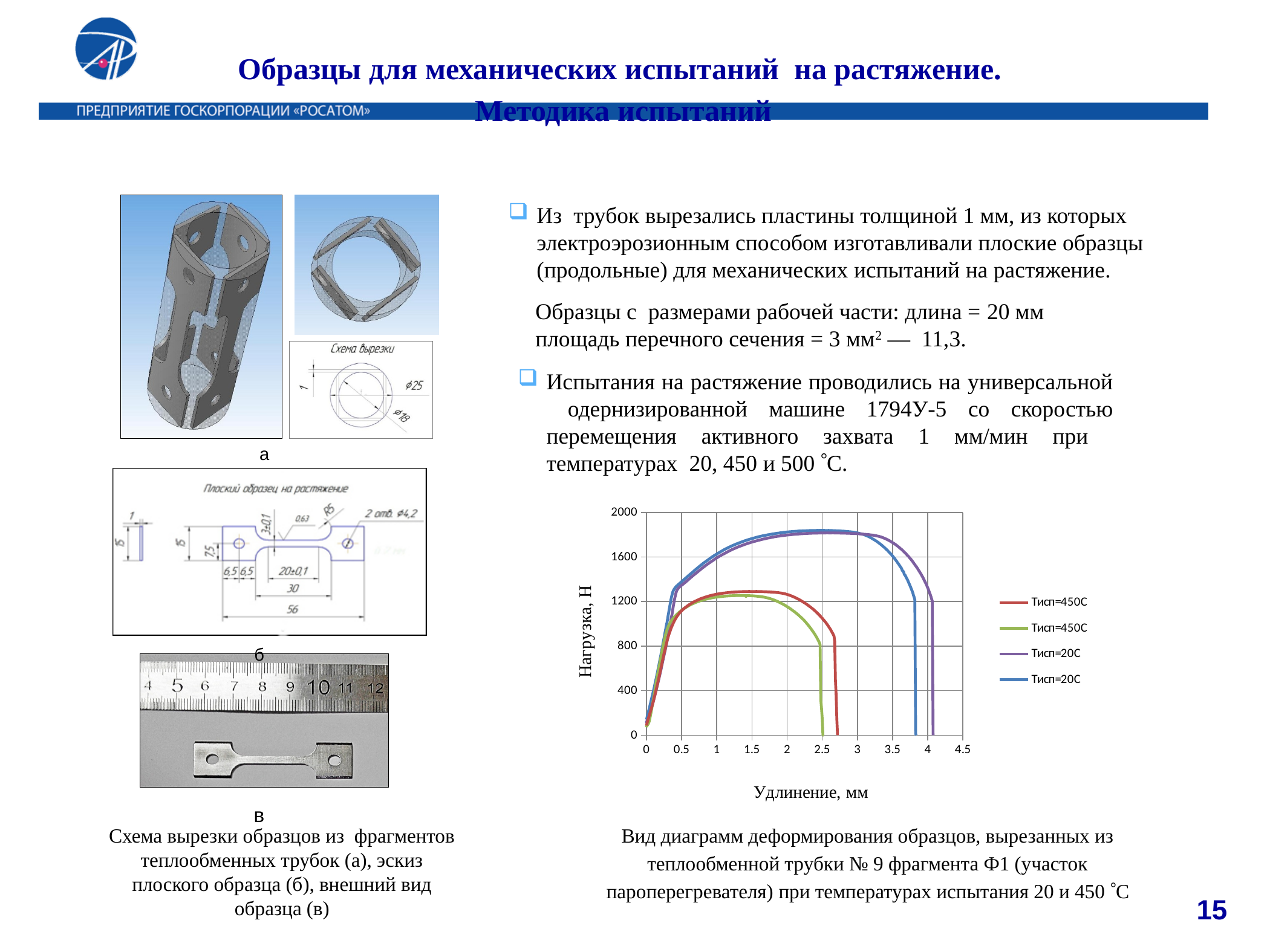
What is the highest value shown on the vertical axis of the chart? 2000 Is the elongation at which the green Тисп=450С curve drops to zero greater or less than 3? less Is the elongation at which the blue Тисп=20С curve drops to zero greater or less than 3.5? greater What is the label of the horizontal axis of the chart? Удлинение, мм How many series does the chart legend list? 4 Which curve ends at the largest elongation: the purple Тисп=20С curve or the red Тисп=450С curve? purple Тисп=20С Is the maximum load reached by the red Тисп=450С curve greater or less than 1600? less What is the label of the vertical axis of the chart? Нагрузка, Н What kind of chart is shown on the slide? line chart Which reach a higher maximum load: the Тисп=20С curves or the Тисп=450С curves? Тисп=20С